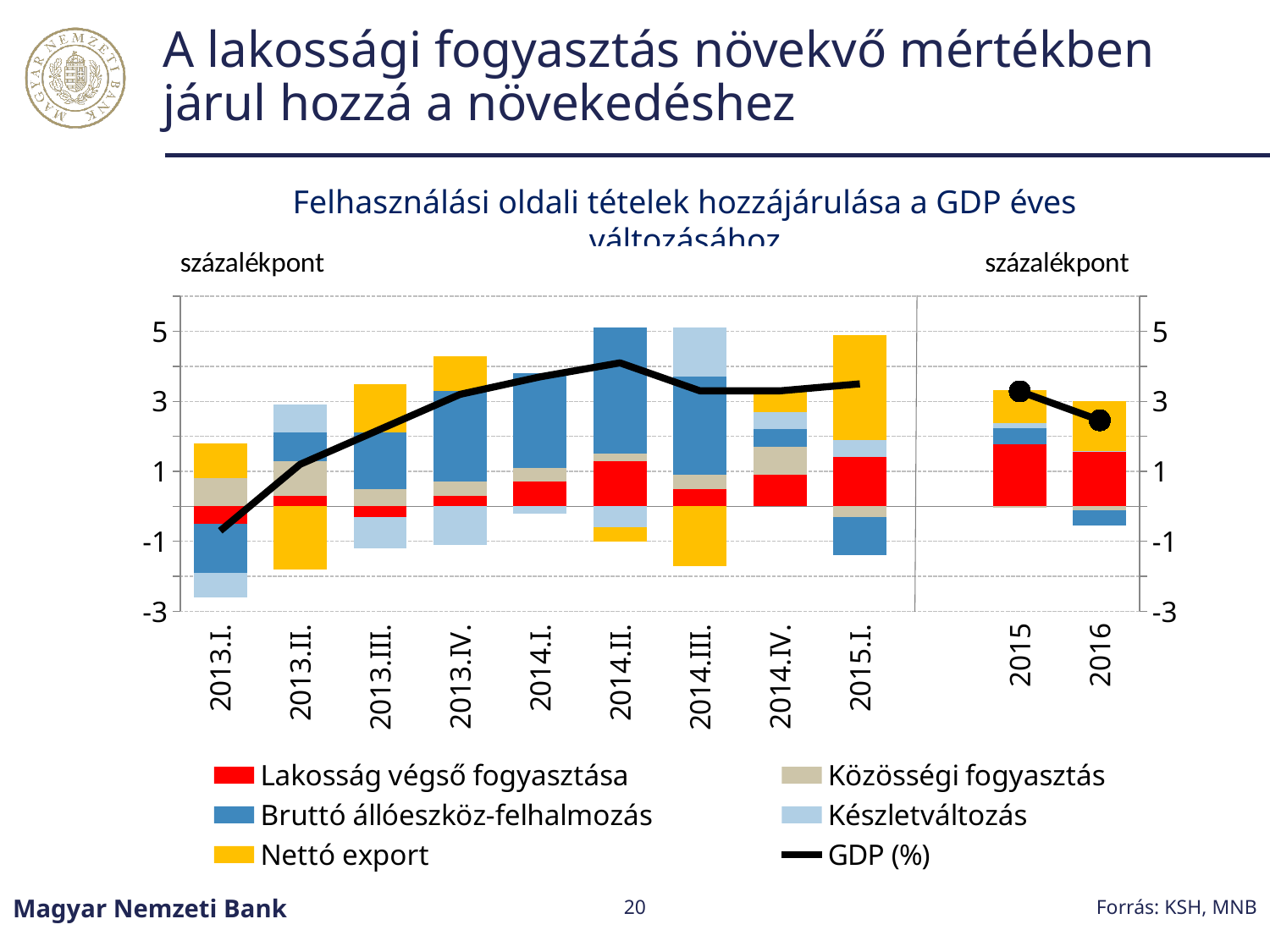
How many categories are shown on the x axis? 11 Does the GDP (%) line rise or fall from 2013.I. to 2014.II.? rises How many series does the legend list? 6 Which quarter has the lowest GDP (%) value? 2013.I. Does the GDP (%) line rise or fall from 2015 to 2016? falls Is the GDP (%) value for 2014.II. greater or less than 3? greater Which is larger, the GDP (%) value for 2014.II. or for 2013.I.? 2014.II. What kind of chart is shown on the slide? Bar chart with a line Which quarter has the highest GDP (%) value? 2014.II. Is the GDP (%) value for 2013.I. greater or less than 1? less Is the GDP (%) value for 2016 greater or less than 3? less Which legend entry is shown as a black line? GDP (%)